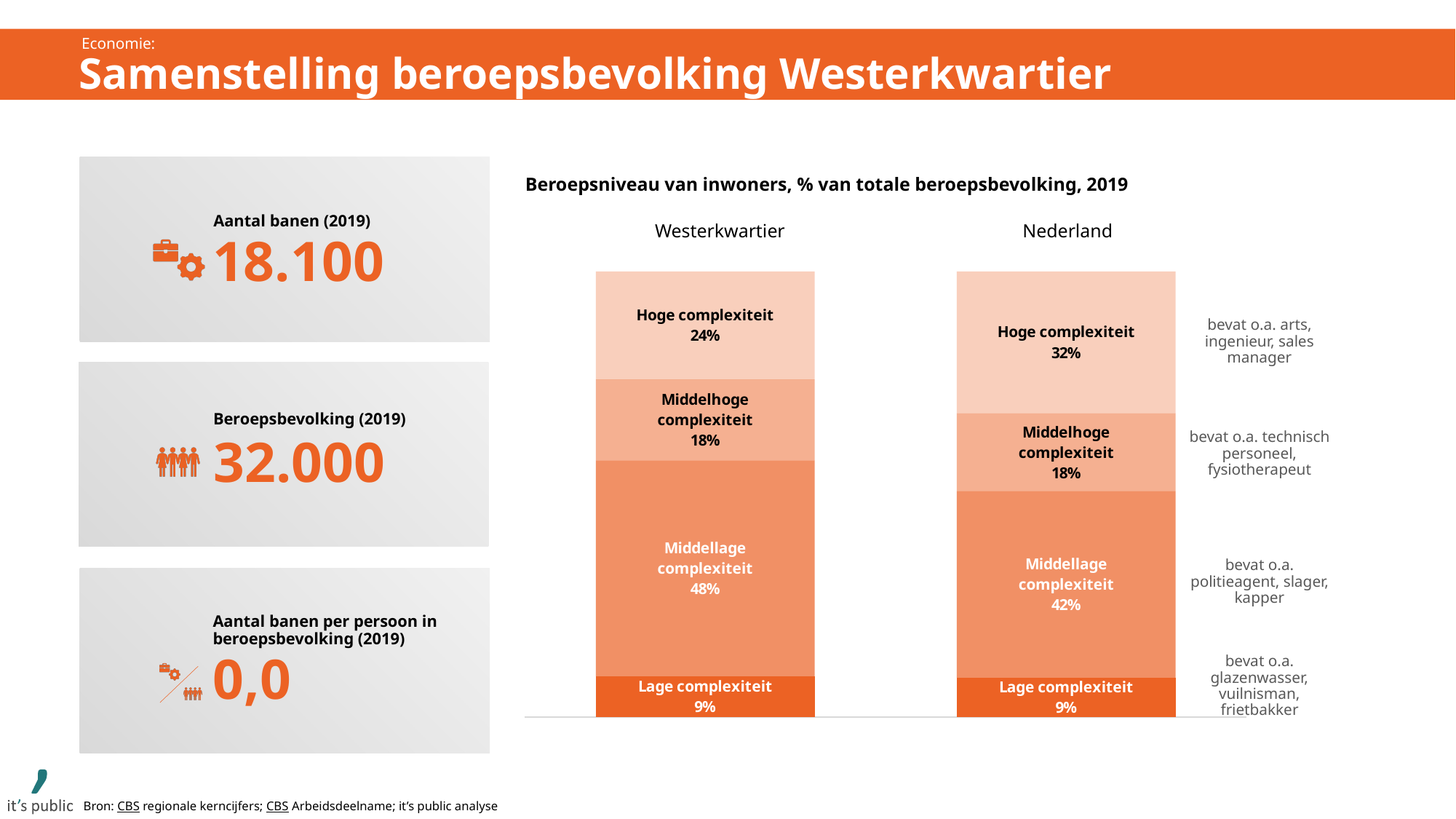
What is the share of 'Hoge complexiteit' in the Nederland bar? 32% Which has a larger share of 'Middellage complexiteit', Westerkwartier or Nederland? Westerkwartier How many percentage points higher is 'Hoge complexiteit' in Nederland than in Westerkwartier? 8 Which segment is the largest in the Westerkwartier bar? Middellage complexiteit What is the share of 'Lage complexiteit' in the Nederland bar? 9% How many segments (complexity levels) does each bar in the chart have? 4 What is the share of 'Hoge complexiteit' in the Westerkwartier bar? 24% What is the share of 'Middellage complexiteit' in the Westerkwartier bar? 48% What is the share of 'Middellage complexiteit' in the Nederland bar? 42% What kind of chart is shown under the title 'Beroepsniveau van inwoners, % van totale beroepsbevolking, 2019'? Stacked bar chart How many bars does the chart contain? 2 Which segment is the smallest in the Nederland bar? Lage complexiteit